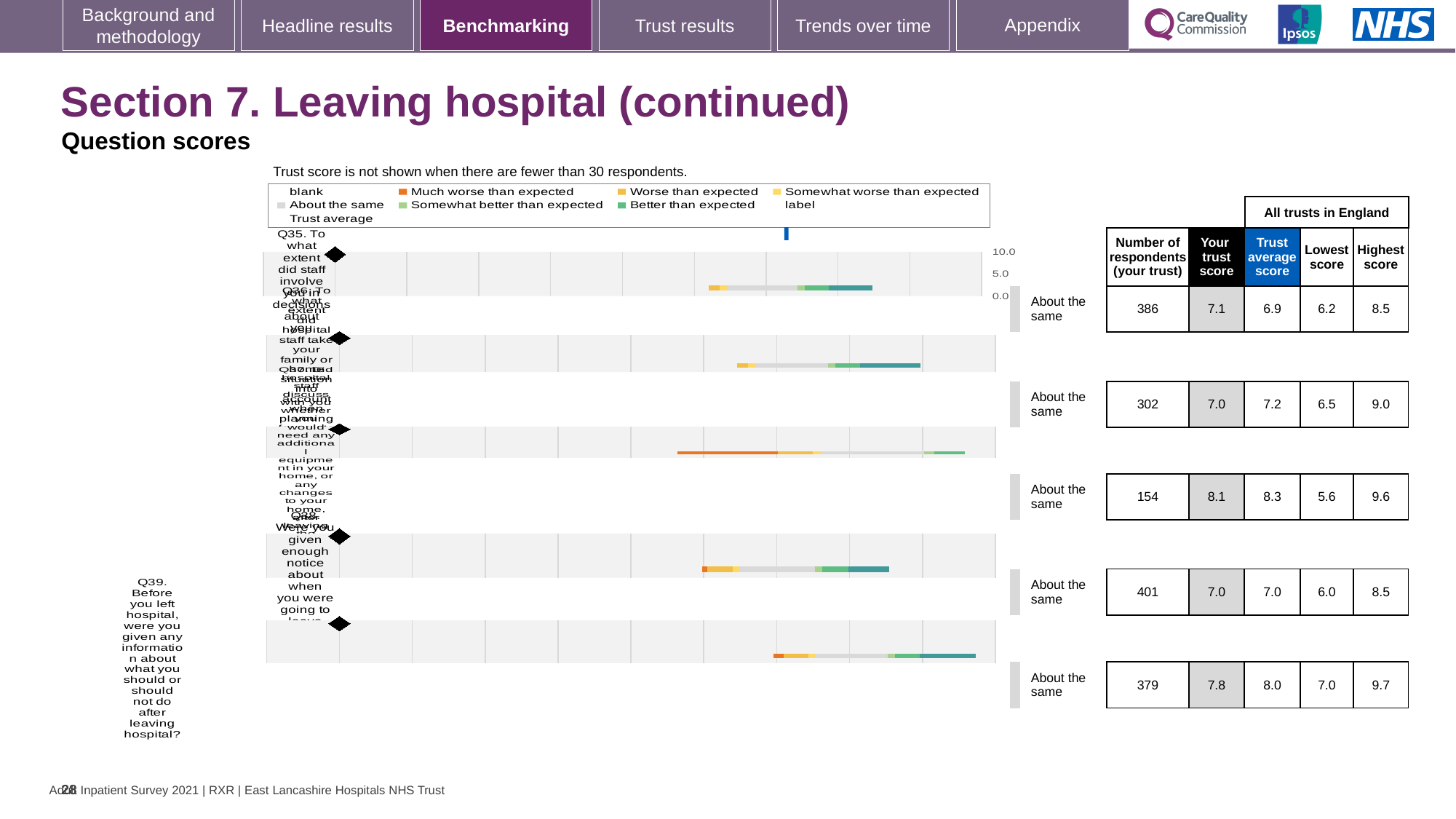
What is the trust average score for Q39? 8.0 Which question has the fewest respondents? Q37 What is the maximum value shown on the score axis of the chart? 10.0 How many questions (rows) are plotted in the question scores chart? 5 How many respondents does the table show for Q38? 401 For Q39, which is larger: the trust's own score or the trust average score? Trust average score What kind of chart is used to show the question scores on this slide? bar chart What is the 'Your trust score' value for Q35? 7.1 What is the highest score across all trusts in England for Q37? 9.6 What is the difference between the highest score (9.6) and the lowest score (5.6) for Q37? 4.0 What benchmark category is shown for every question on this slide? About the same Which question has the highest 'Your trust score'? Q37